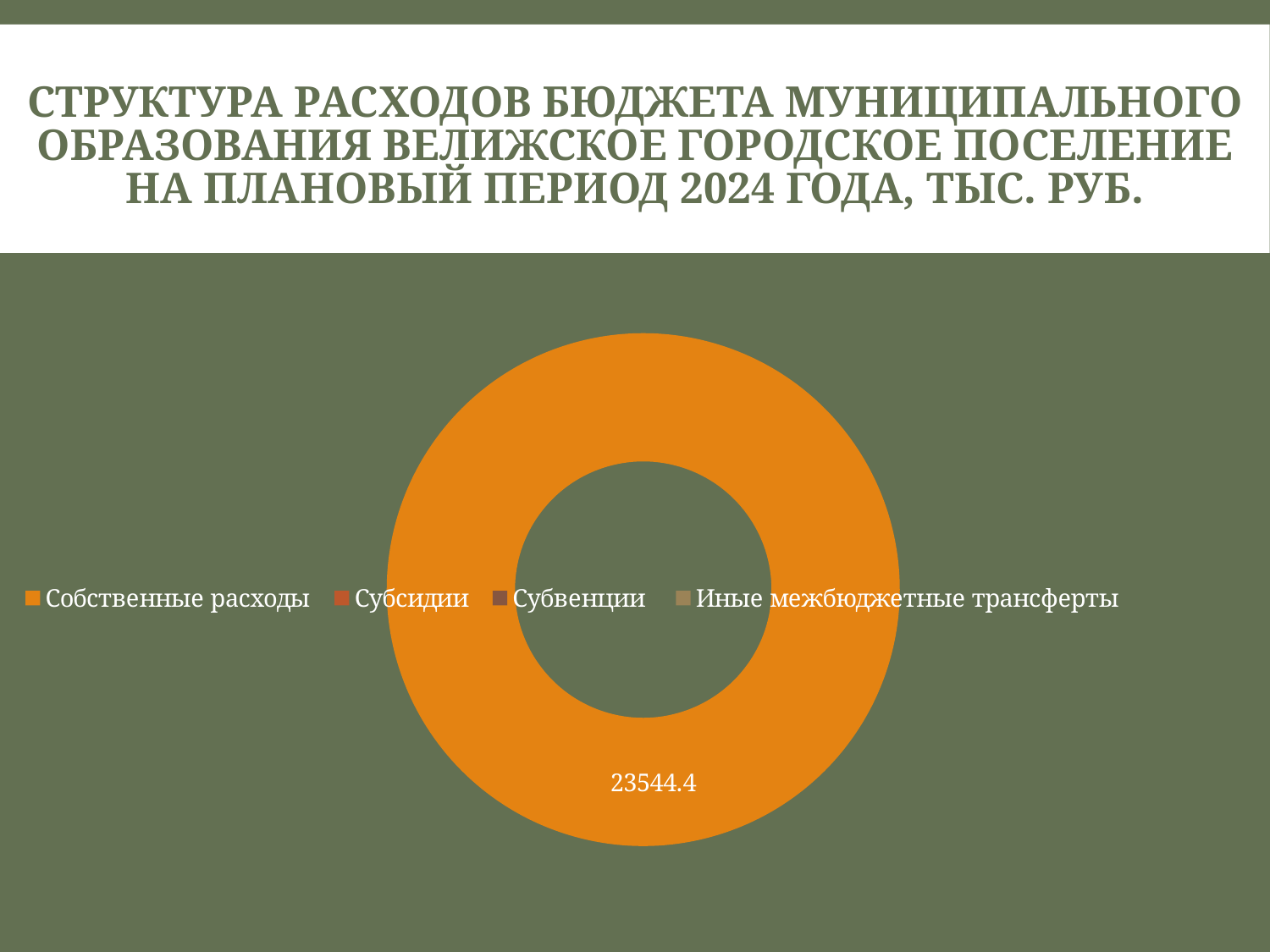
What kind of chart is shown on the slide? Doughnut (pie) chart In what units are the values on the chart expressed, according to the slide title? тыс. руб. How many data labels are printed on the chart? 1 Which category fills the entire ring of the doughnut chart? Собственные расходы What colour represents Собственные расходы in the chart? Orange What value is shown for Собственные расходы on the chart? 23544.4 How many entries does the chart legend list? 4 Which legend entry is listed last? Иные межбюджетные трансферты Which category has the largest value on the chart? Собственные расходы